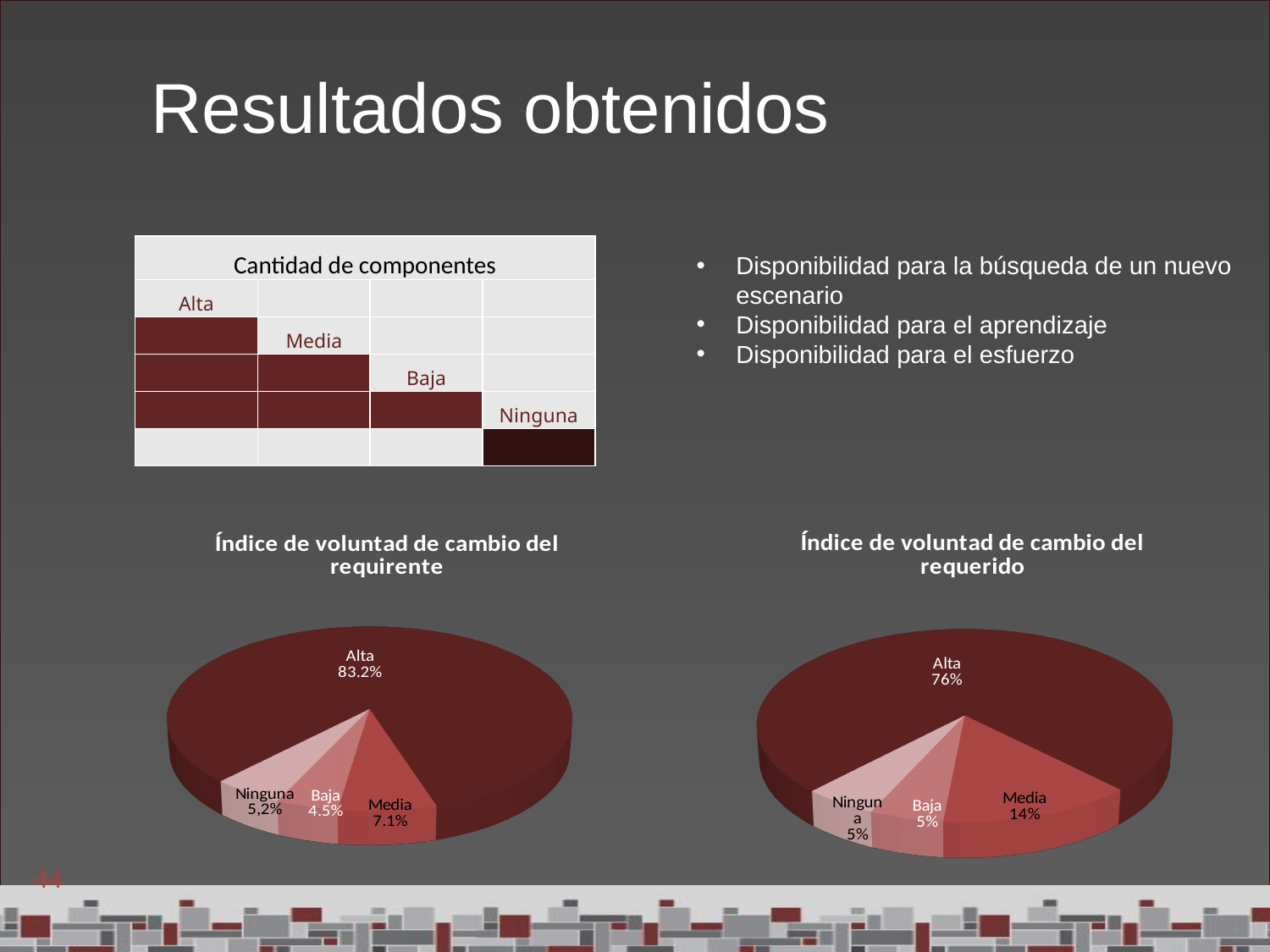
In the chart titled 'Índice de voluntad de cambio del requirente', what is the value for Ninguna? 5,2% In the chart titled 'Índice de voluntad de cambio del requerido', what is the difference between Alta and Media? 62% In the chart titled 'Índice de voluntad de cambio del requerido', which category has the largest slice? Alta In the chart titled 'Índice de voluntad de cambio del requerido', what is the value for Alta? 76% In the chart titled 'Índice de voluntad de cambio del requerido', what is the value for Media? 14% In the chart titled 'Índice de voluntad de cambio del requirente', what is the value for Media? 7.1% In the chart titled 'Índice de voluntad de cambio del requirente', which is larger, Media or Baja? Media In the chart titled 'Índice de voluntad de cambio del requirente', what is the value for Alta? 83.2% In the chart titled 'Índice de voluntad de cambio del requirente', which category has the smallest slice? Baja How many categories does the chart titled 'Índice de voluntad de cambio del requerido' show? 4 What kind of chart is 'Índice de voluntad de cambio del requirente'? Pie chart In the chart titled 'Índice de voluntad de cambio del requirente', which category has the largest slice? Alta